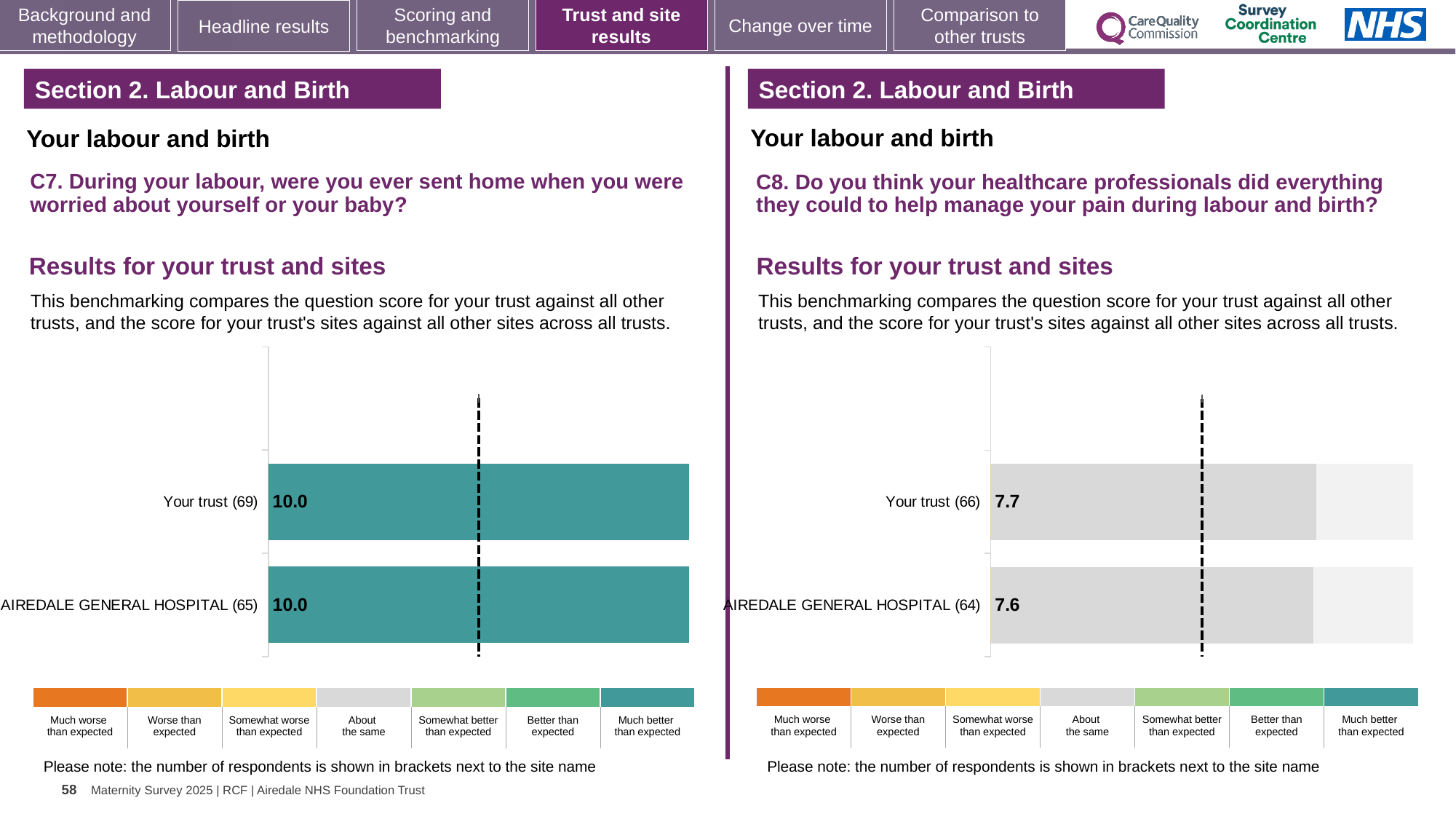
What type of chart is used in the C7 chart on the left? Bar chart In the C8 chart on the right, which has the higher score, Your trust or AIREDALE GENERAL HOSPITAL? Your trust In the C7 chart on the left, how many respondents are shown in brackets for AIREDALE GENERAL HOSPITAL? 65 In the C7 chart on the left, how many bars are plotted? 2 In the C8 chart on the right, what is the score for Your trust (66)? 7.7 In the C8 chart on the right, what is the difference between the score for Your trust and the score for AIREDALE GENERAL HOSPITAL? 0.1 In the C8 chart on the right, what is the score for AIREDALE GENERAL HOSPITAL (64)? 7.6 In the C8 chart on the right, how many bars are plotted? 2 In the C8 chart on the right, which benchmark category does the grey colour of the bars correspond to in the legend? About the same In the C7 chart on the left, what is the score for Your trust (69)? 10.0 In the C7 chart on the left, what is the score for AIREDALE GENERAL HOSPITAL (65)? 10.0